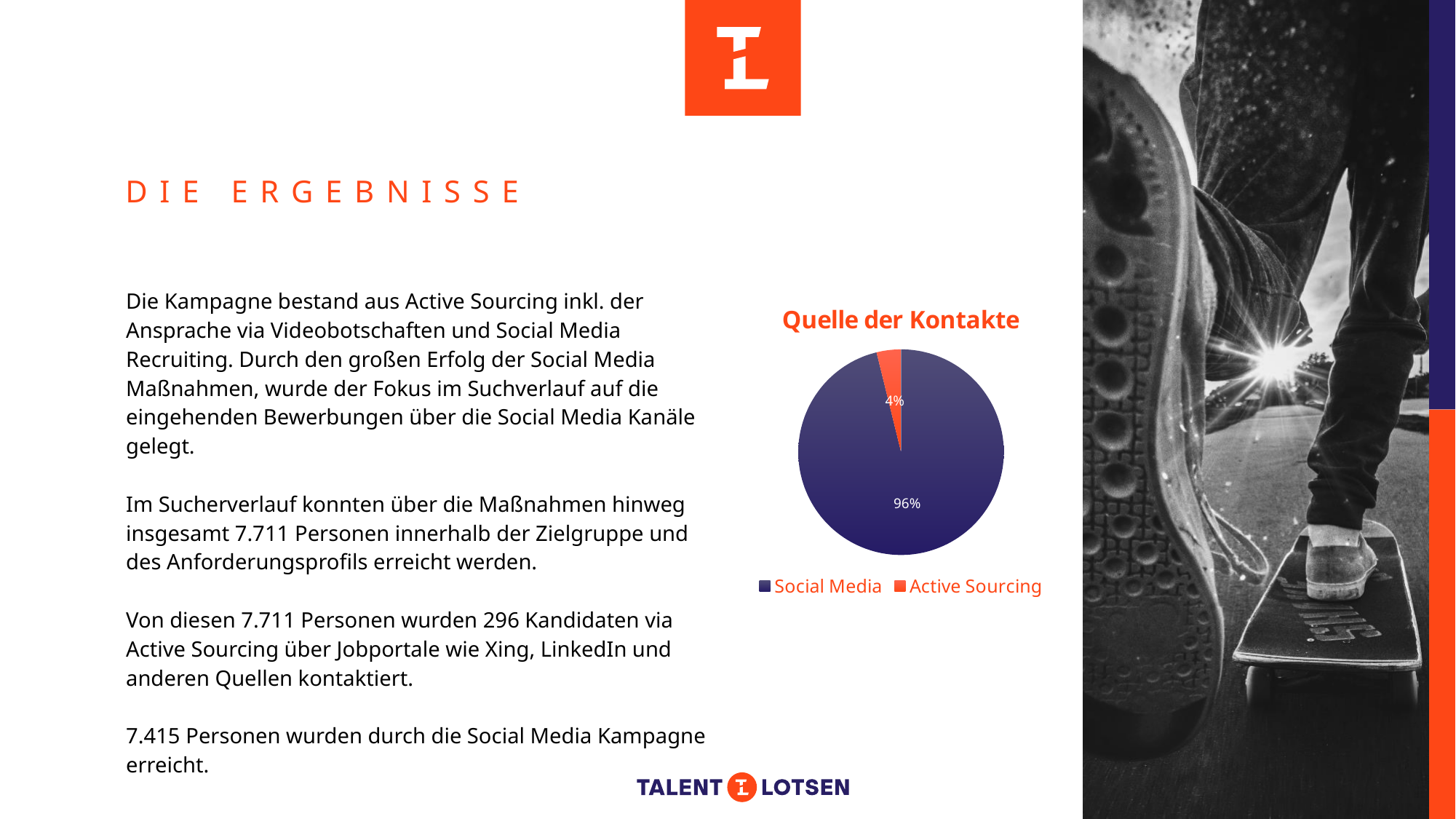
What share of the pie does Active Sourcing account for? 4% What kind of chart is shown on the slide? pie chart How many entries does the legend list? 2 How many categories does the pie chart show? 2 What is the title of the chart? Quelle der Kontakte What colour is the Active Sourcing slice? orange Which is larger, the Social Media slice or the Active Sourcing slice? Social Media What share of the pie does Social Media account for? 96% Which category has the largest slice of the pie? Social Media What is the difference in percentage points between the Social Media and Active Sourcing slices? 92 Which category has the smallest slice of the pie? Active Sourcing